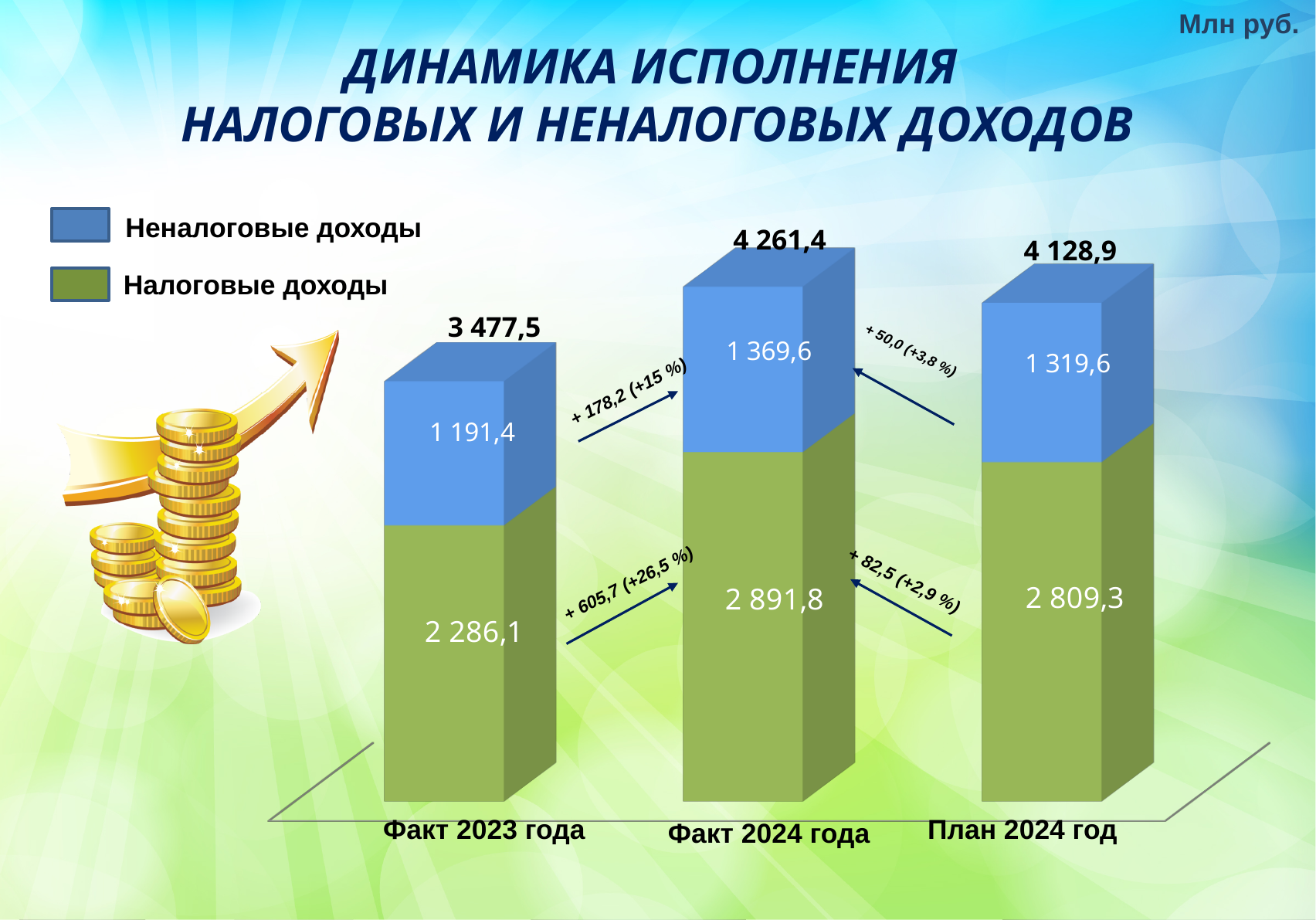
What is the total of the stacked bar for Факт 2023 года? 3 477,5 What is the difference in Налоговые доходы between Факт 2024 года and Факт 2023 года? 605,7 Which category has the lowest value of Неналоговые доходы? Факт 2023 года How many series does the legend list? 2 How many categories are shown on the x axis? 3 Which is larger: Налоговые доходы for Факт 2024 года or for План 2024 год? Факт 2024 года What is the value of Налоговые доходы for План 2024 год? 2 809,3 What is the value of Неналоговые доходы for Факт 2024 года? 1 369,6 What is the value of Налоговые доходы for Факт 2023 года? 2 286,1 Which category has the highest total? Факт 2024 года What is the total of the stacked bar for Факт 2024 года? 4 261,4 What is the difference in Неналоговые доходы between Факт 2024 года and План 2024 год? 50,0